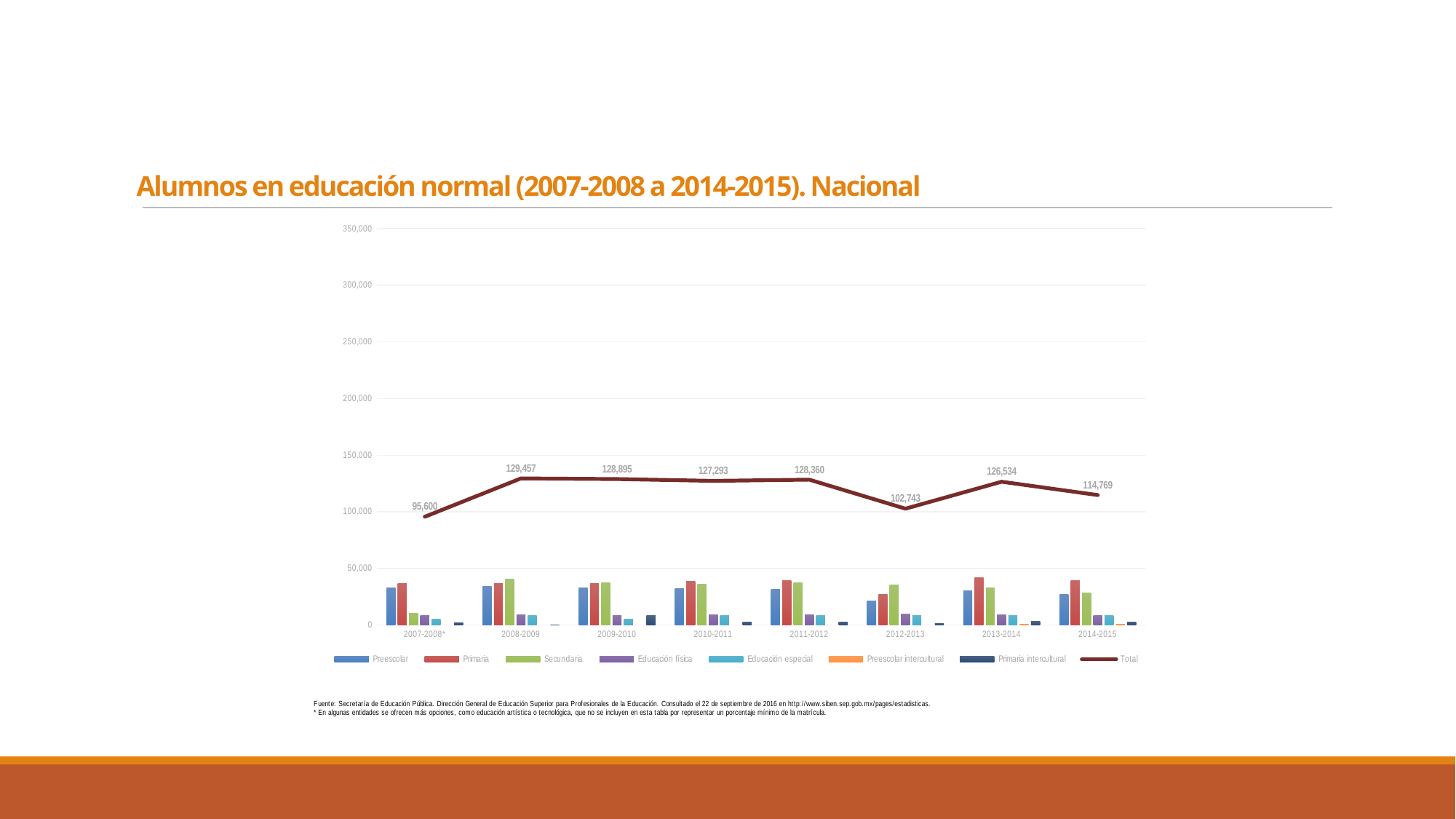
How many series does the legend list? 8 What is the Total value for 2007-2008*? 95,600 How many school years are shown on the x axis? 8 What is the difference between the Total for 2011-2012 and the Total for 2012-2013? 25,617 In which school year is the Total highest? 2008-2009 What is the Total value for 2008-2009? 129,457 What is the title of the chart? Alumnos en educación normal (2007-2008 a 2014-2015). Nacional What is the Total value for 2014-2015? 114,769 What is the difference between the Total for 2008-2009 and the Total for 2007-2008*? 33,857 In which school year is the Total lowest? 2007-2008* Is the Total value for 2012-2013 greater or less than 100,000? greater Which is larger, the Total for 2013-2014 or the Total for 2014-2015? 2013-2014